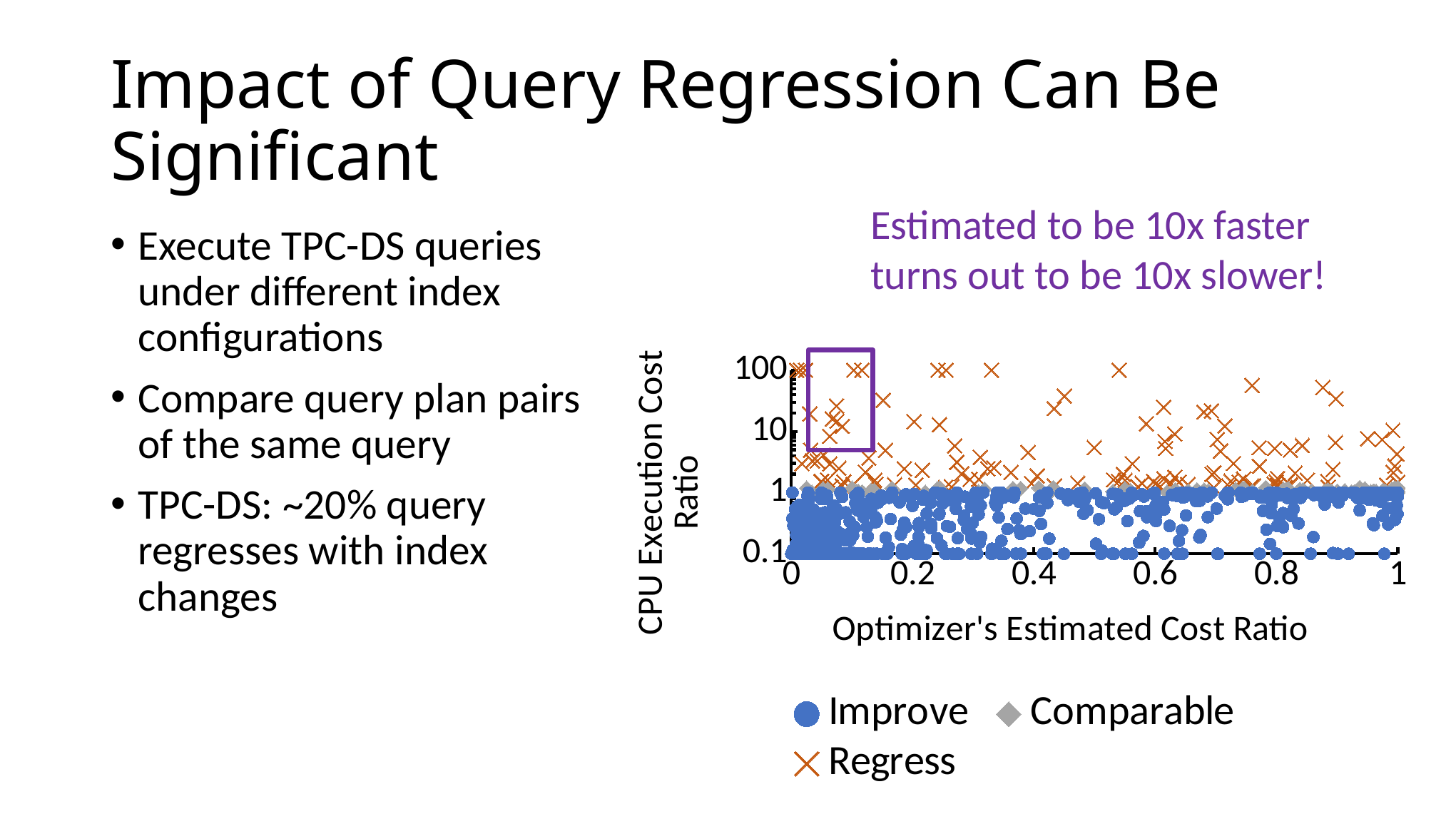
Which series is plotted with orange cross markers? Regress What kind of chart is shown on the slide? scatter chart What is the maximum value labelled on the chart's x axis? 1 What are the three series named in the chart's legend? Improve, Comparable, Regress How many series does the chart's legend list? 3 Are the Regress points plotted at CPU Execution Cost Ratio values greater or less than 1? greater Are the Improve points plotted at CPU Execution Cost Ratio values greater or less than 1? less